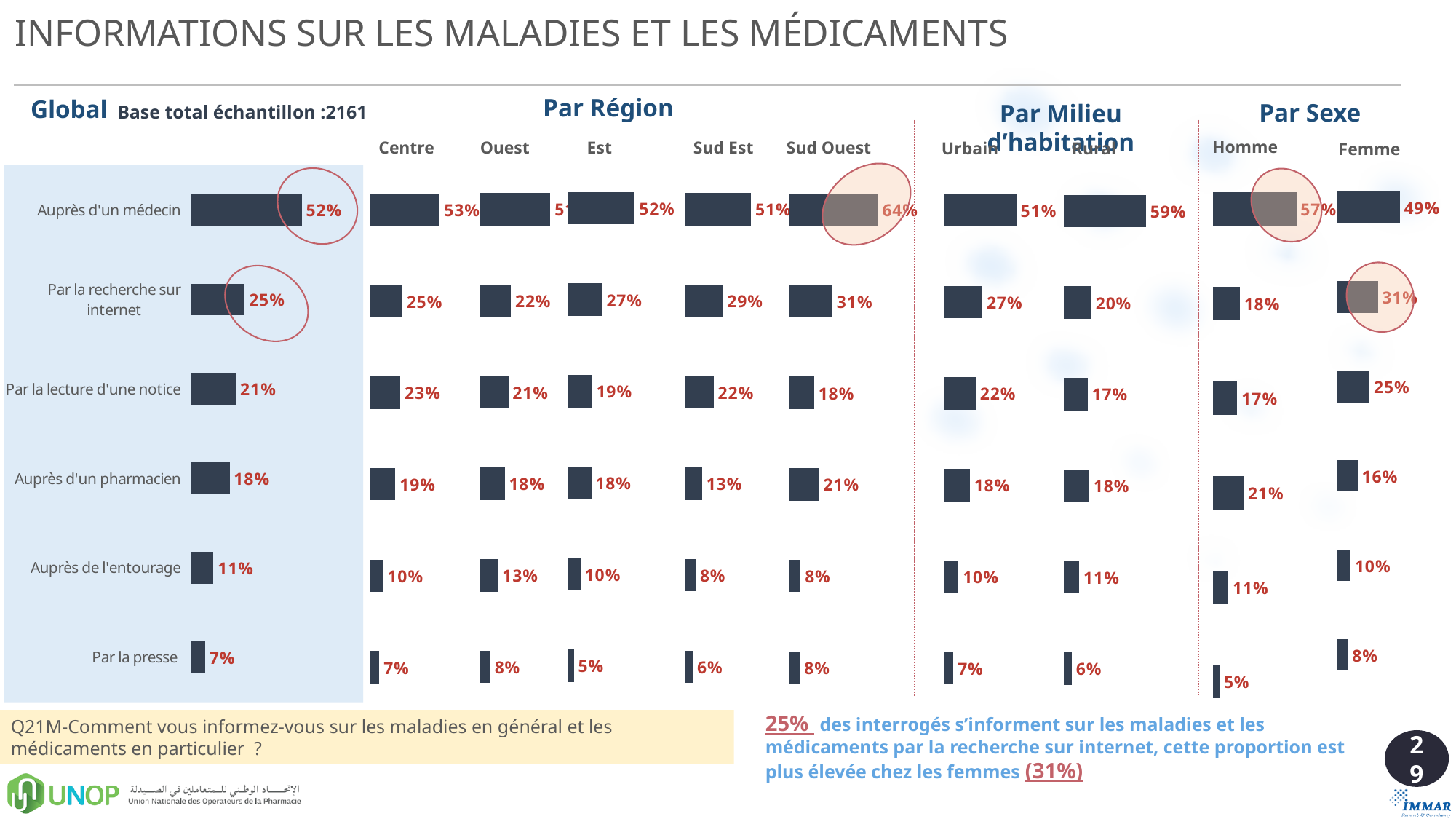
In the Global chart, how many information sources (categories) are listed? 6 In the Par Milieu d'habitation charts, which is larger for Auprès d'un médecin: Urbain or Rural? Rural In the Par Région charts, what is the value for Auprès d'un pharmacien in the Sud Est region? 13% In the Par Sexe charts, what is the value for Par la presse among Homme? 5% In the Par Région charts, which region has the highest value for Par la recherche sur internet? Sud Ouest In the Global chart, what percentage of respondents get information from a doctor (Auprès d'un médecin)? 52% What kind of chart is used in the Global section? Bar chart In the Global chart, what is the difference between Auprès d'un médecin and Par la recherche sur internet? 27 percentage points In the Global chart, which information source has the lowest percentage? Par la presse In the Par Région charts, what is the value for Auprès d'un médecin in the Sud Ouest region? 64% In the Par Sexe charts, what is the difference between Femme and Homme for Par la recherche sur internet? 13 percentage points What is the base total sample size shown for the Global chart? 2161